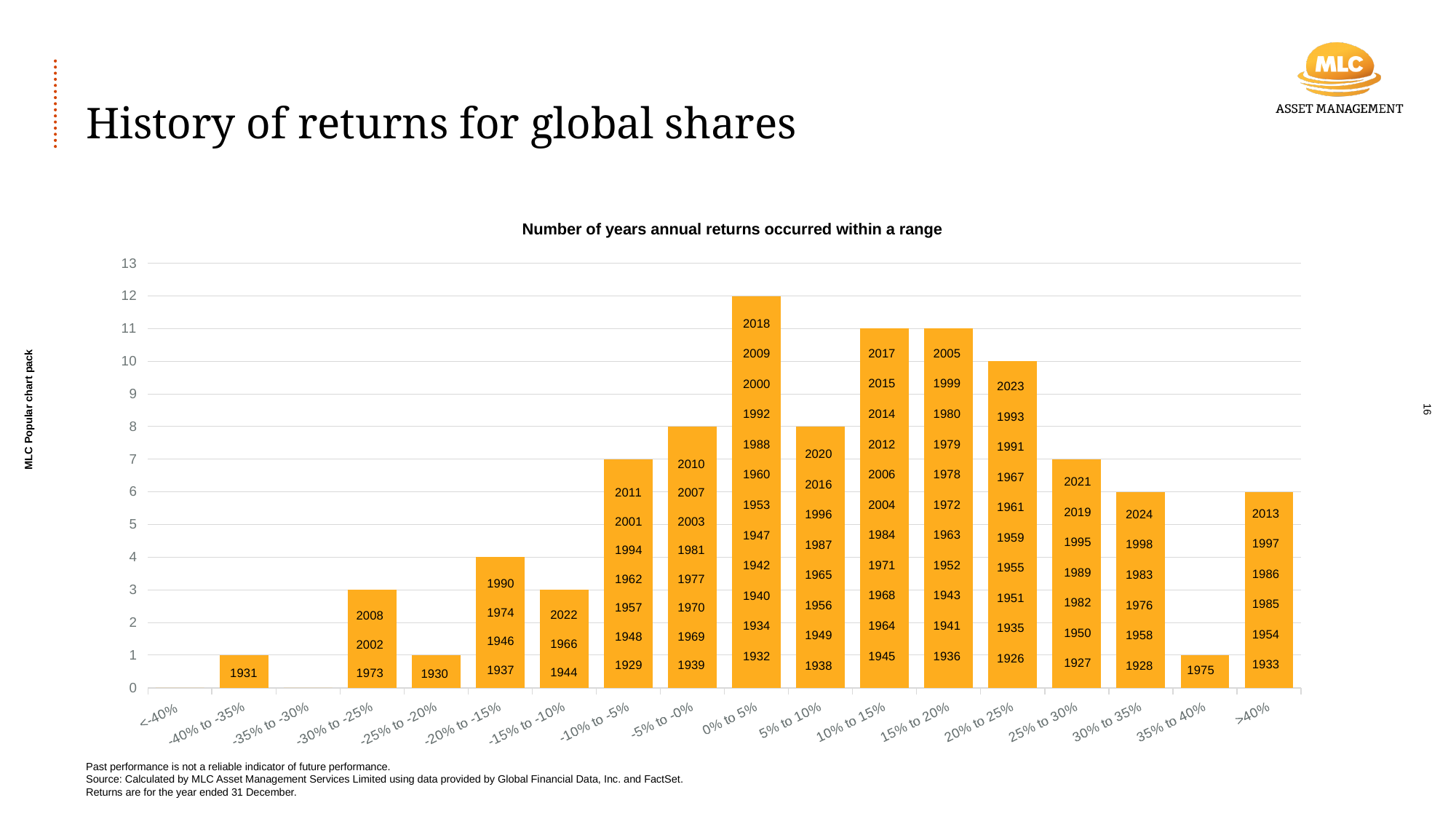
Which has more years: the -10% to -5% range or the 30% to 35% range? -10% to -5% What is the title of the chart? Number of years annual returns occurred within a range What type of chart is shown on the slide? bar chart Is the number of years in the 10% to 15% range greater or less than 10? greater How many return-range categories are shown on the x axis? 18 How many years had annual returns greater than 40%? 6 Which return range has the highest number of years? 0% to 5% What is the difference between the number of years in the 0% to 5% range and the number in the 20% to 25% range? 2 Which year is the only one in the 35% to 40% range? 1975 How many years had annual returns in the -30% to -25% range? 3 How many years had annual returns in the 0% to 5% range? 12 How many years had annual returns in the -20% to -15% range? 4